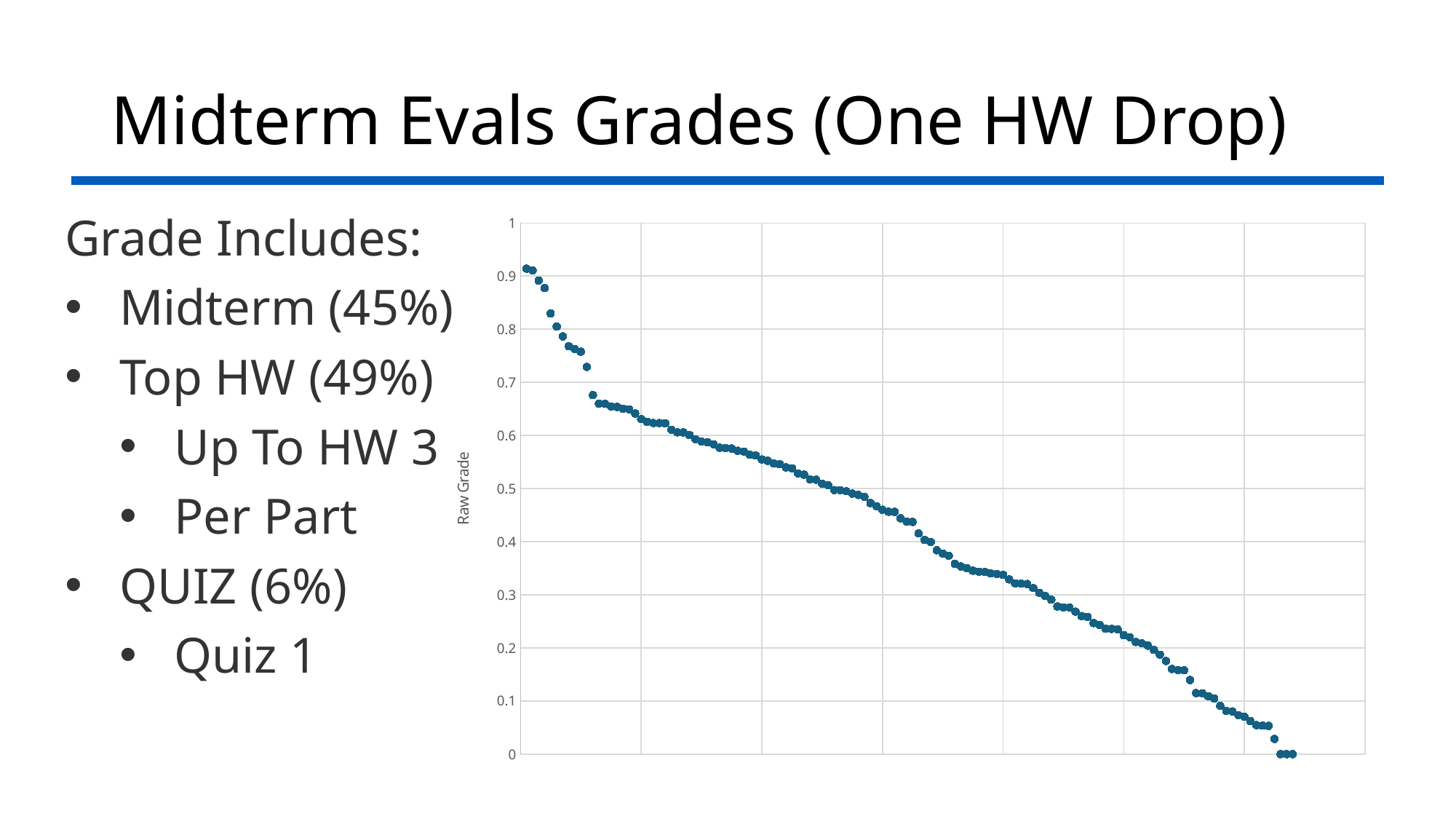
What kind of chart is shown on the slide? scatter chart Is the value of the leftmost plotted point greater or less than 0.7? greater Is the value of the rightmost plotted point greater or less than 0.1? less What is the lowest Raw Grade value plotted on the chart? 0 What is the label on the vertical axis of the chart? Raw Grade Is the highest plotted Raw Grade value greater or less than 0.8? greater Do the plotted values rise or fall from left to right along the x axis? fall What is the highest value shown on the vertical axis of the chart? 1